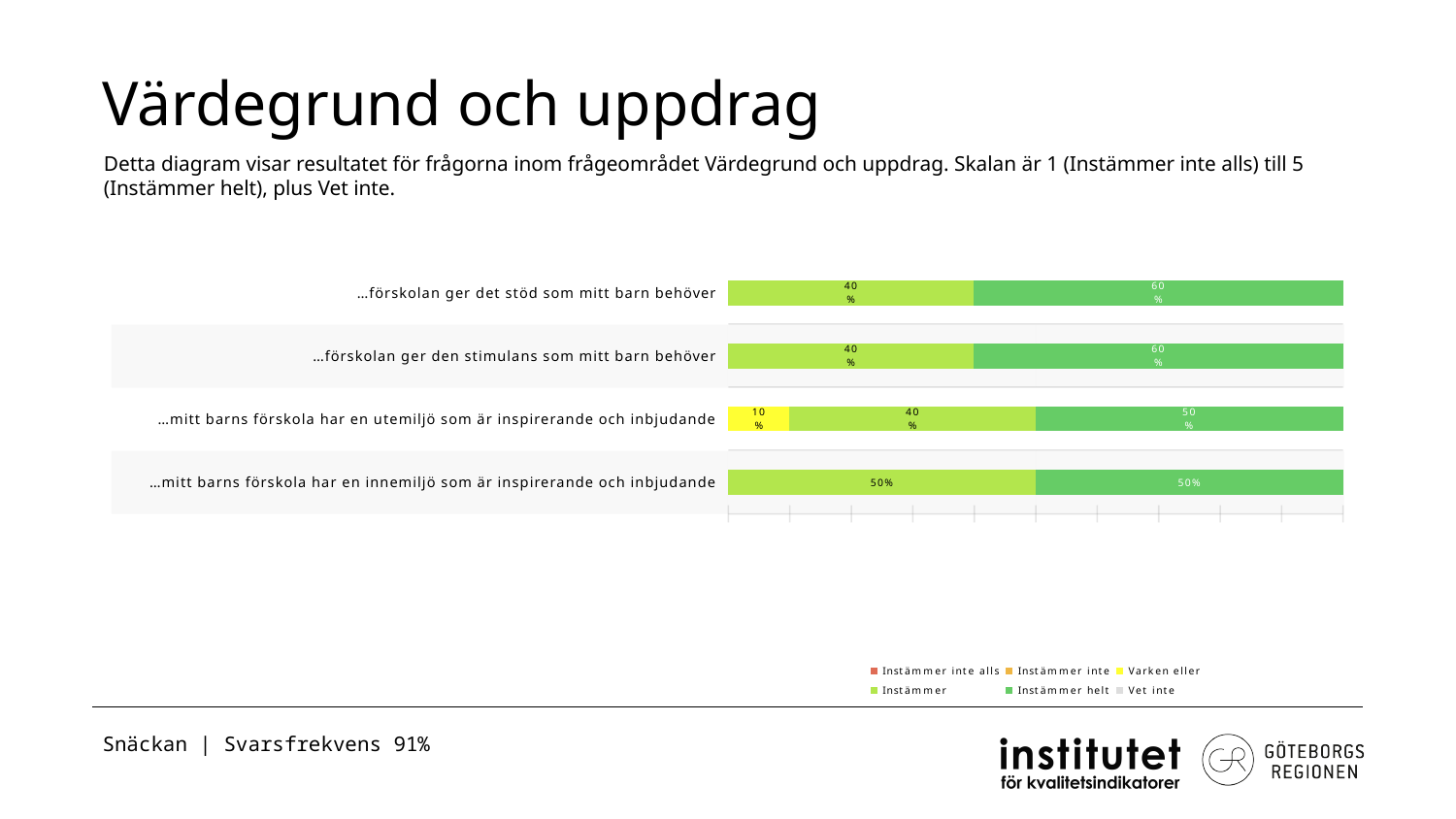
What is the 'Instämmer helt' value for '…förskolan ger det stöd som mitt barn behöver'? 60% How many series does the legend list? 6 What kind of chart is shown on the slide? Stacked bar chart What is the 'Varken eller' value for '…mitt barns förskola har en utemiljö som är inspirerande och inbjudande'? 10% What is the 'Instämmer' value for '…förskolan ger den stimulans som mitt barn behöver'? 40% What is the 'Instämmer helt' value for '…mitt barns förskola har en innemiljö som är inspirerande och inbjudande'? 50% How many categories (questions) are plotted in the chart? 4 Which is larger for '…mitt barns förskola har en utemiljö som är inspirerande och inbjudande': the 'Instämmer' value or the 'Instämmer helt' value? Instämmer helt What is the difference between the 'Instämmer helt' and 'Instämmer' values for '…förskolan ger det stöd som mitt barn behöver'? 20% What is the response rate (Svarsfrekvens) shown on the slide? 91% What is the total of the 'Instämmer' and 'Instämmer helt' segments for '…mitt barns förskola har en utemiljö som är inspirerande och inbjudande'? 90% Which category has the lowest 'Instämmer helt' value? …mitt barns förskola har en utemiljö som är inspirerande och inbjudande and …mitt barns förskola har en innemiljö som är inspirerande och inbjudande (both 50%)